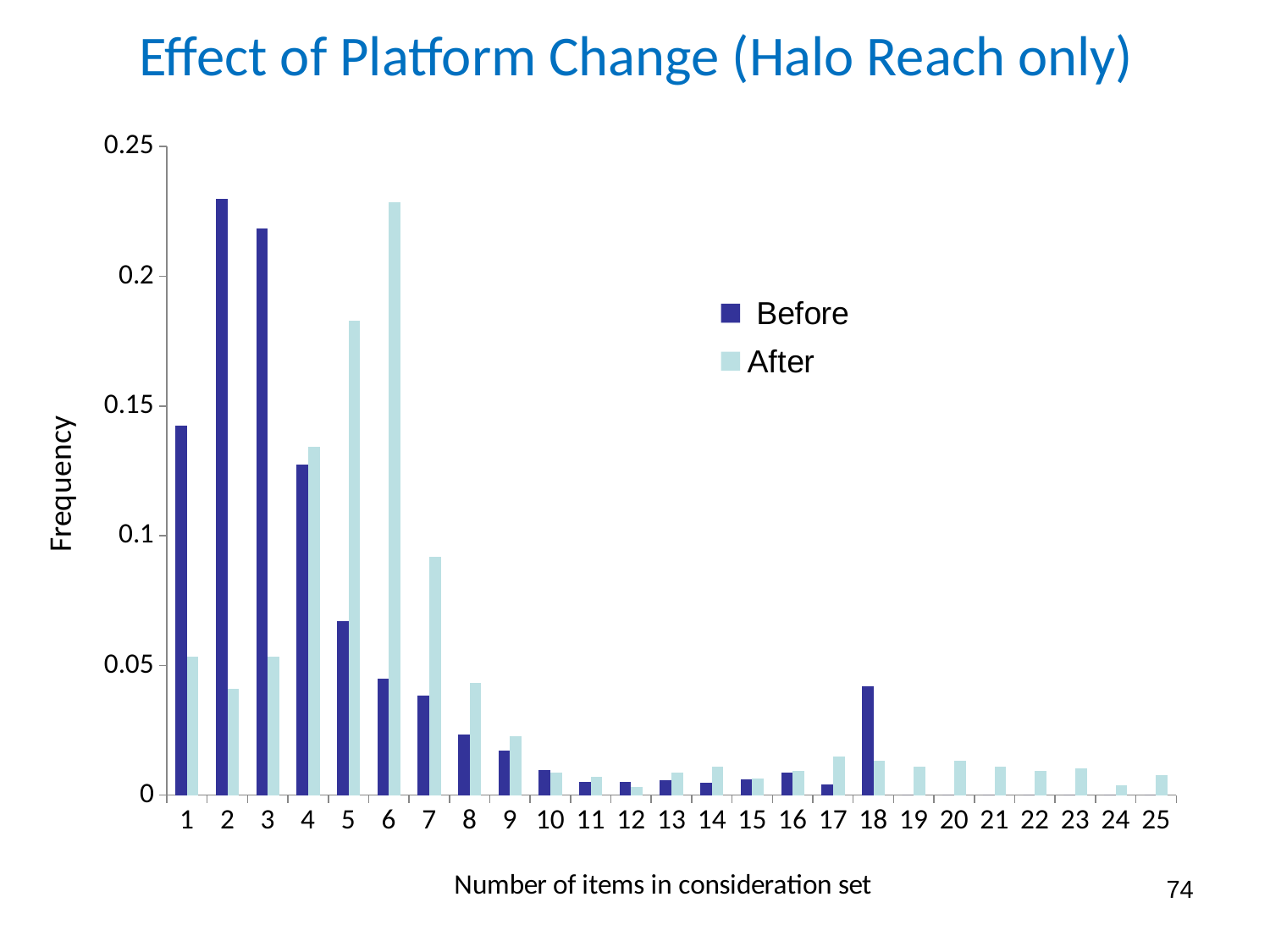
For 1 item in the consideration set, which series has the higher frequency, Before or After? Before For 7 items in the consideration set, which series has the higher frequency, Before or After? After What kind of chart is shown on the slide? bar chart What is the label of the x axis? Number of items in consideration set Is the Before frequency for 3 items greater or less than 0.2? greater How many categories are shown on the x axis? 25 For the After series, which number of items in the consideration set has the highest frequency? 6 For the Before series, which number of items in the consideration set has the highest frequency? 2 Do the After frequencies rise or fall from 6 items to 9 items? fall Is the After frequency for 5 items greater or less than 0.15? greater Is the After frequency for 7 items greater or less than 0.1? less How many series does the legend list? 2